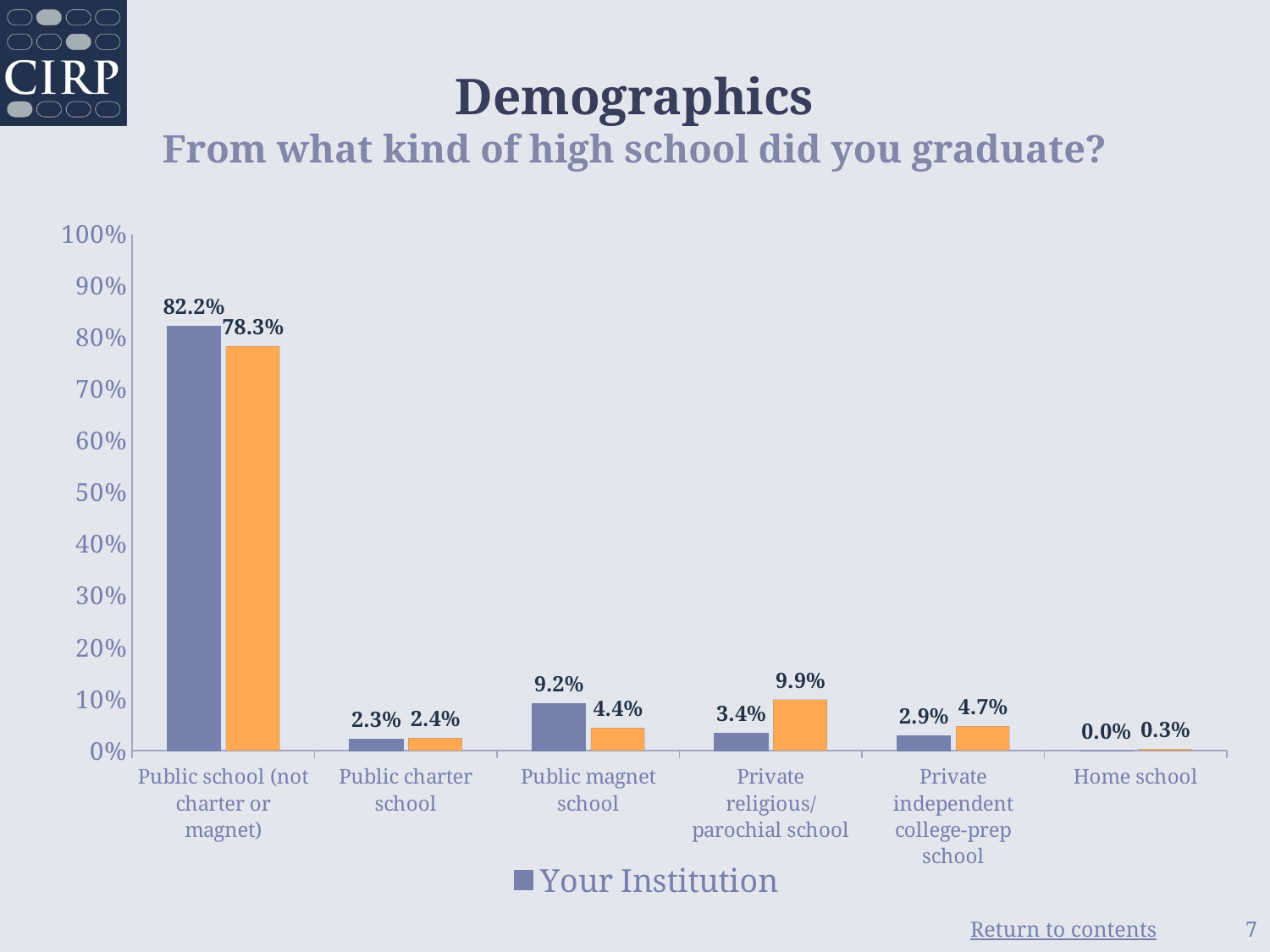
What kind of chart is shown on the slide? Bar chart What is the difference between the Your Institution value and the orange bar value for Public school (not charter or magnet)? 3.9% Which category has the lowest Your Institution value? Home school Which category has the highest Your Institution value? Public school (not charter or magnet) For Public magnet school, which is larger: the Your Institution bar or the orange bar? Your Institution How many high school categories are shown on the x axis? 6 For Private religious/parochial school, which is larger: the Your Institution bar or the orange bar? The orange bar How many series does the legend list? 1 What is the Your Institution value for Public magnet school? 9.2% What is the Your Institution value for Home school? 0.0% What is the value of the orange bar for Private religious/parochial school? 9.9% What percentage of Your Institution respondents graduated from a public school (not charter or magnet)? 82.2%